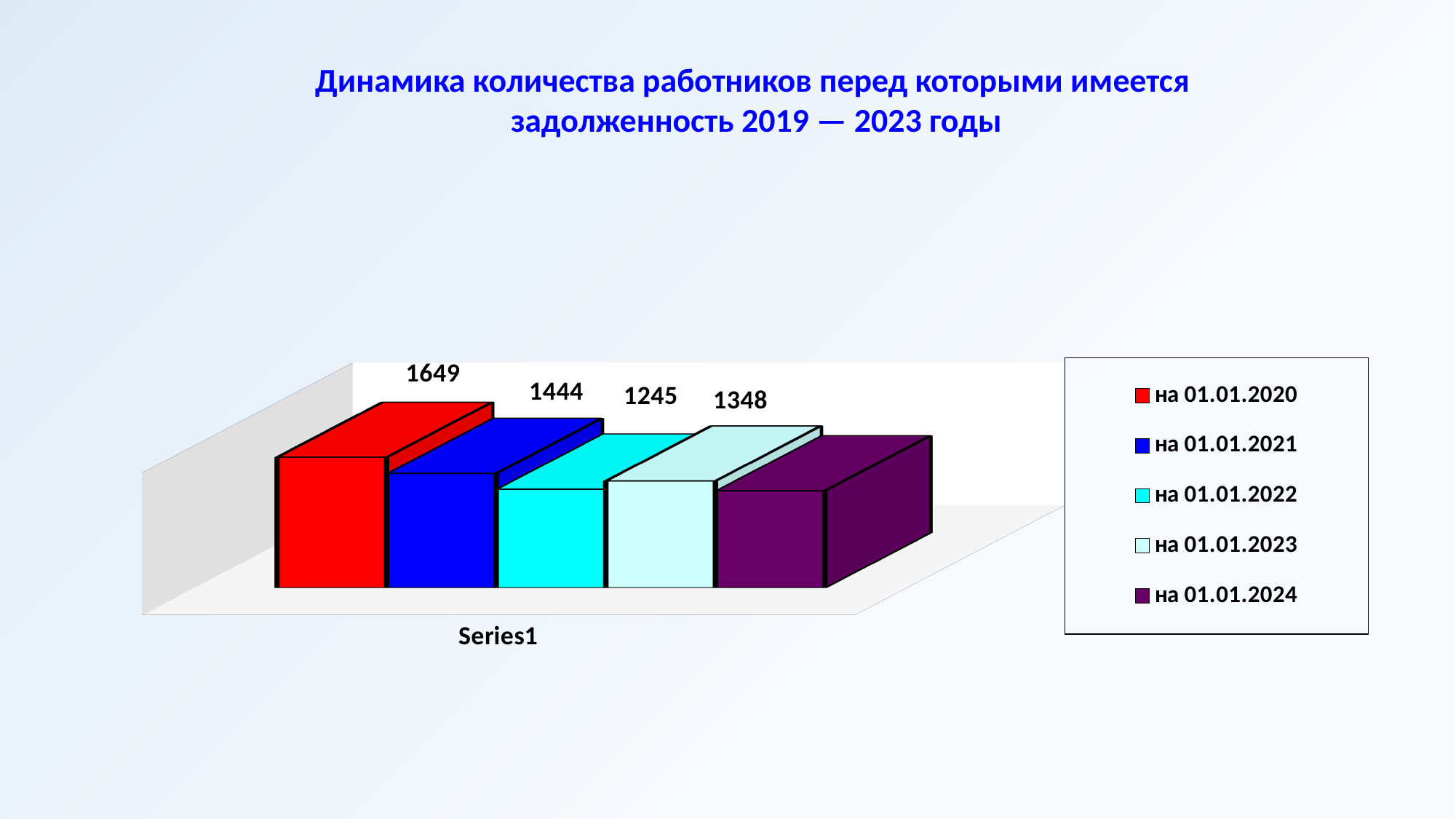
What is the value for на 01.01.2021? 1444 What is the difference between the values for на 01.01.2023 and на 01.01.2022? 103 What kind of chart is shown on the slide? bar chart How many entries does the legend list? 5 What is the value for на 01.01.2023? 1348 Which legend entry has the highest value? на 01.01.2020 Do the values rise or fall from на 01.01.2020 to на 01.01.2022? fall What colour is the bar for на 01.01.2024? purple Which is larger, the value for на 01.01.2021 or the value for на 01.01.2022? на 01.01.2021 What is the difference between the values for на 01.01.2020 and на 01.01.2021? 205 What is the value for на 01.01.2022? 1245 What is the value for на 01.01.2020? 1649